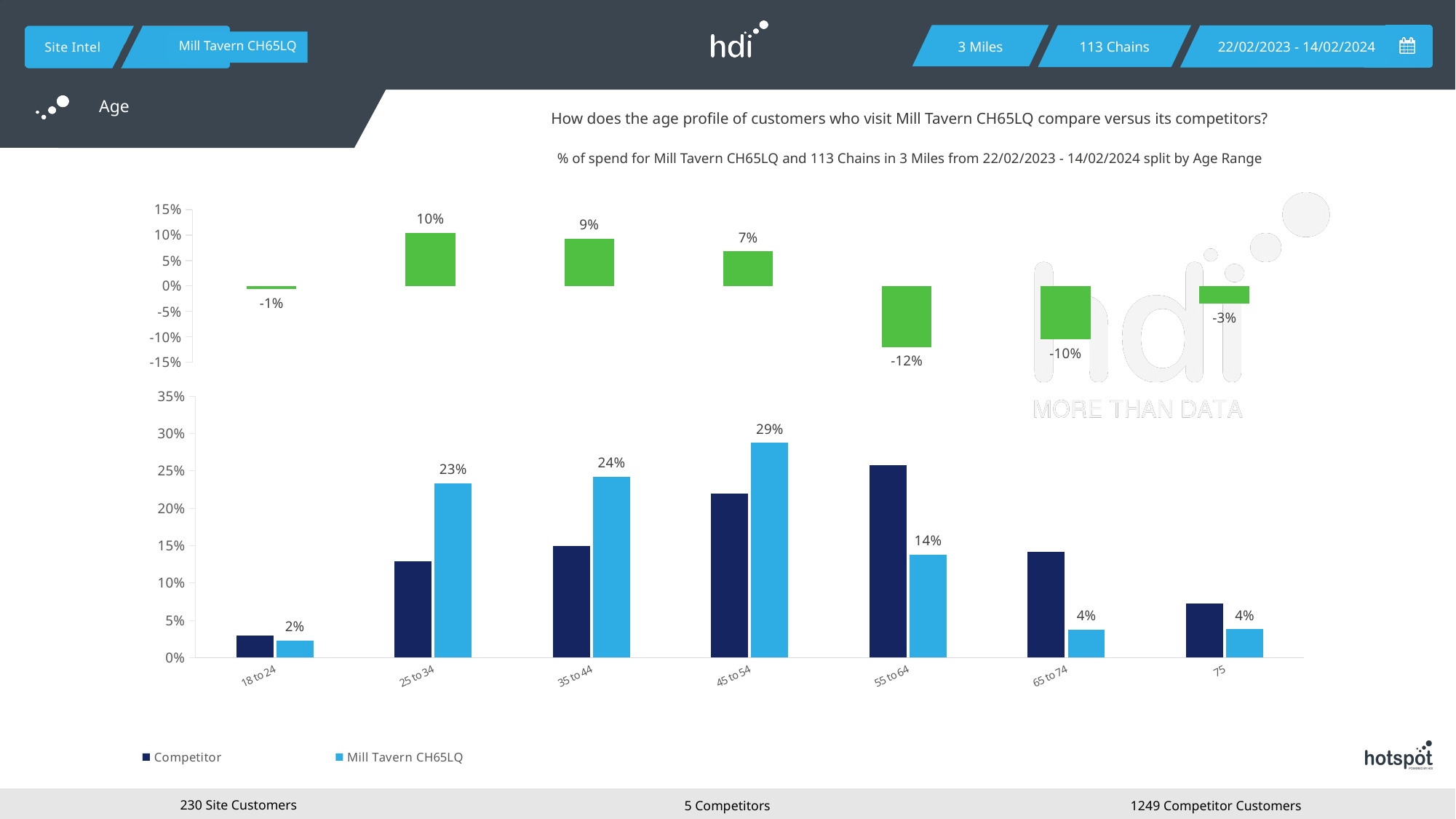
In the bottom chart, which age range has the lowest value for Mill Tavern CH65LQ? 18 to 24 In the bottom chart, what is the value for Mill Tavern CH65LQ in the 25 to 34 age range? 23% In the bottom chart, is the Competitor value for 18 to 24 greater or less than 5%? less In the bottom chart, what is the value for Mill Tavern CH65LQ in the 45 to 54 age range? 29% How many age range categories are shown on the x axis of the bottom chart? 7 In the bottom chart, is the Competitor value for 25 to 34 greater or less than 10%? greater In the bottom chart, what is the difference between the Mill Tavern CH65LQ values for 45 to 54 and 55 to 64? 15% What type of chart is the bottom chart? bar chart How many series does the legend of the bottom chart list? 2 In the top chart, which age range has the highest value? 25 to 34 In the top chart, what is the value shown for the 55 to 64 age range? -12% In the bottom chart, which is larger for the 55 to 64 age range, Competitor or Mill Tavern CH65LQ? Competitor